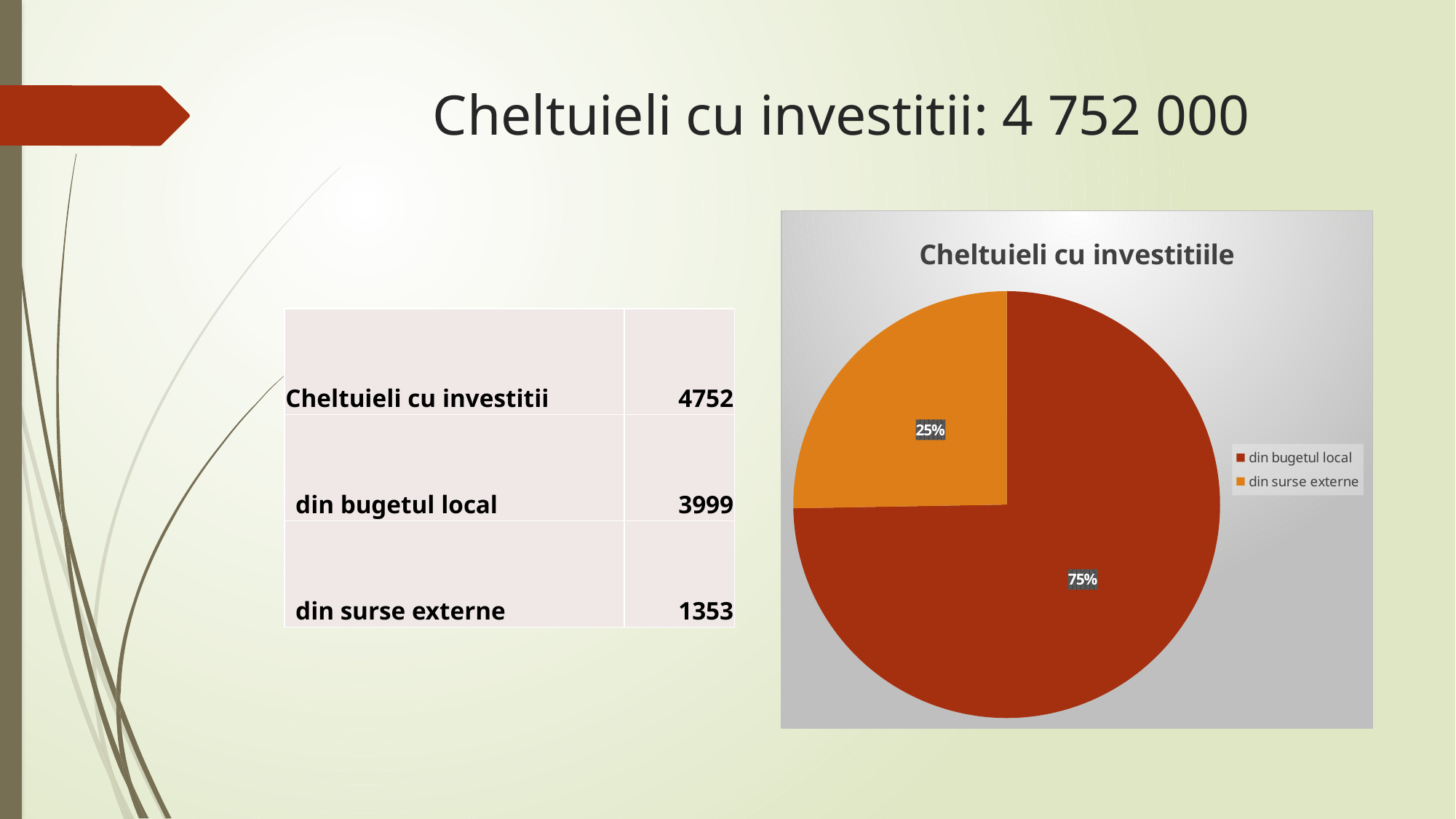
How many slices does the pie chart have? 2 What is the title of the chart? Cheltuieli cu investitiile What kind of chart is shown on the slide? pie chart Which is larger, the share for 'din bugetul local' or the share for 'din surse externe'? din bugetul local How many entries does the legend list? 2 What is the difference in percentage points between the 'din bugetul local' slice and the 'din surse externe' slice? 50 percentage points What colour is the 'din surse externe' slice? orange Which slice of the pie is the largest? din bugetul local What percentage share does the 'din surse externe' slice have? 25% What percentage share does the 'din bugetul local' slice have? 75% Which slice of the pie is the smallest? din surse externe